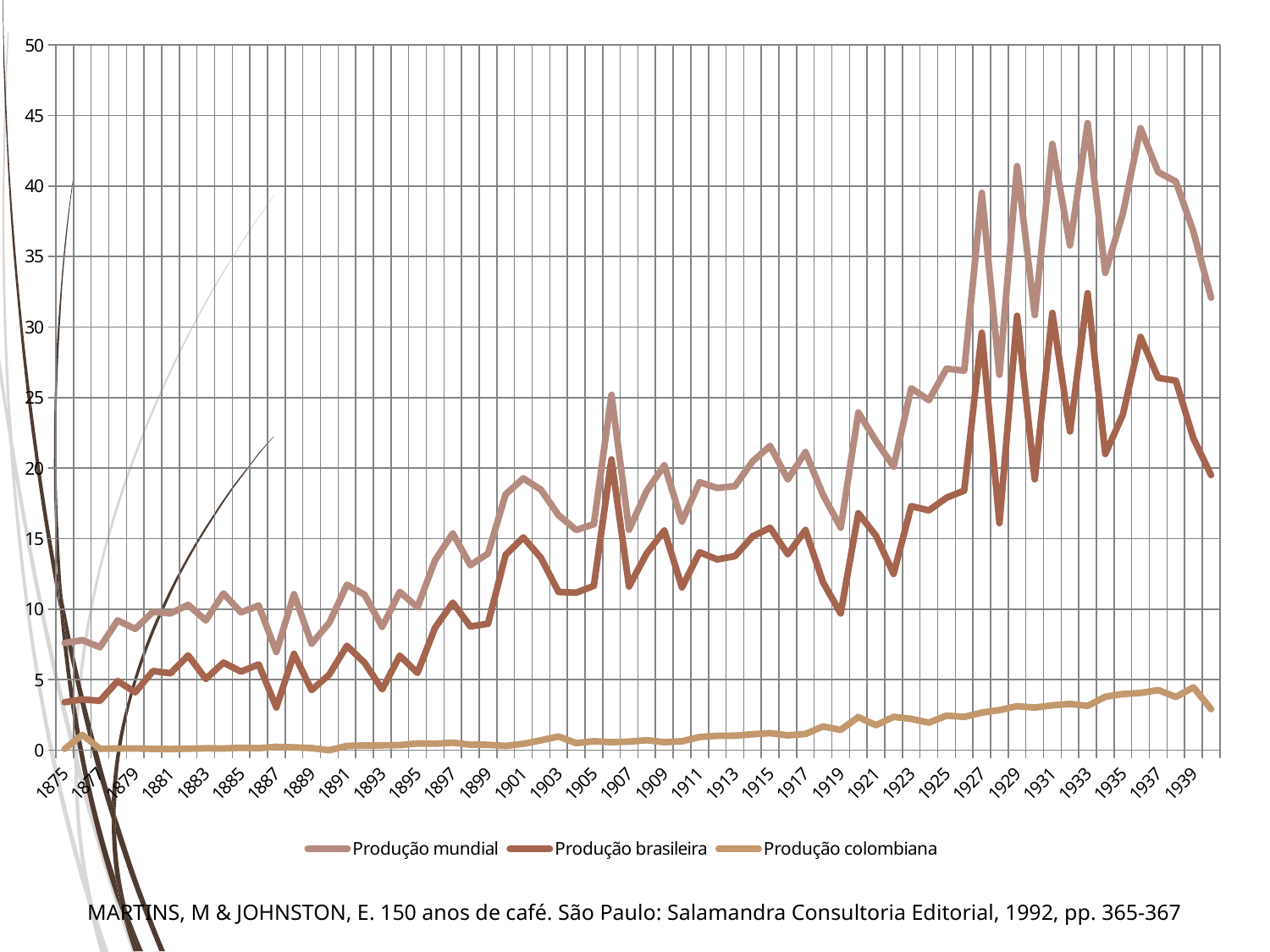
Is the value for Produção brasileira in 1887 greater or less than 5? less In 1939, which is larger: Produção brasileira or Produção colombiana? Produção brasileira How many series does the legend list? 3 Is the value for Produção brasileira in 1933 greater or less than 30? greater Which series reaches the highest values on the chart? Produção mundial Is the value for Produção mundial in 1875 greater or less than 10? less Which series has the lowest values throughout the chart? Produção colombiana What kind of chart is shown on the slide? line chart Overall, does Produção colombiana rise or fall from 1875 to 1939? rise What are the three series named in the legend? Produção mundial, Produção brasileira, Produção colombiana